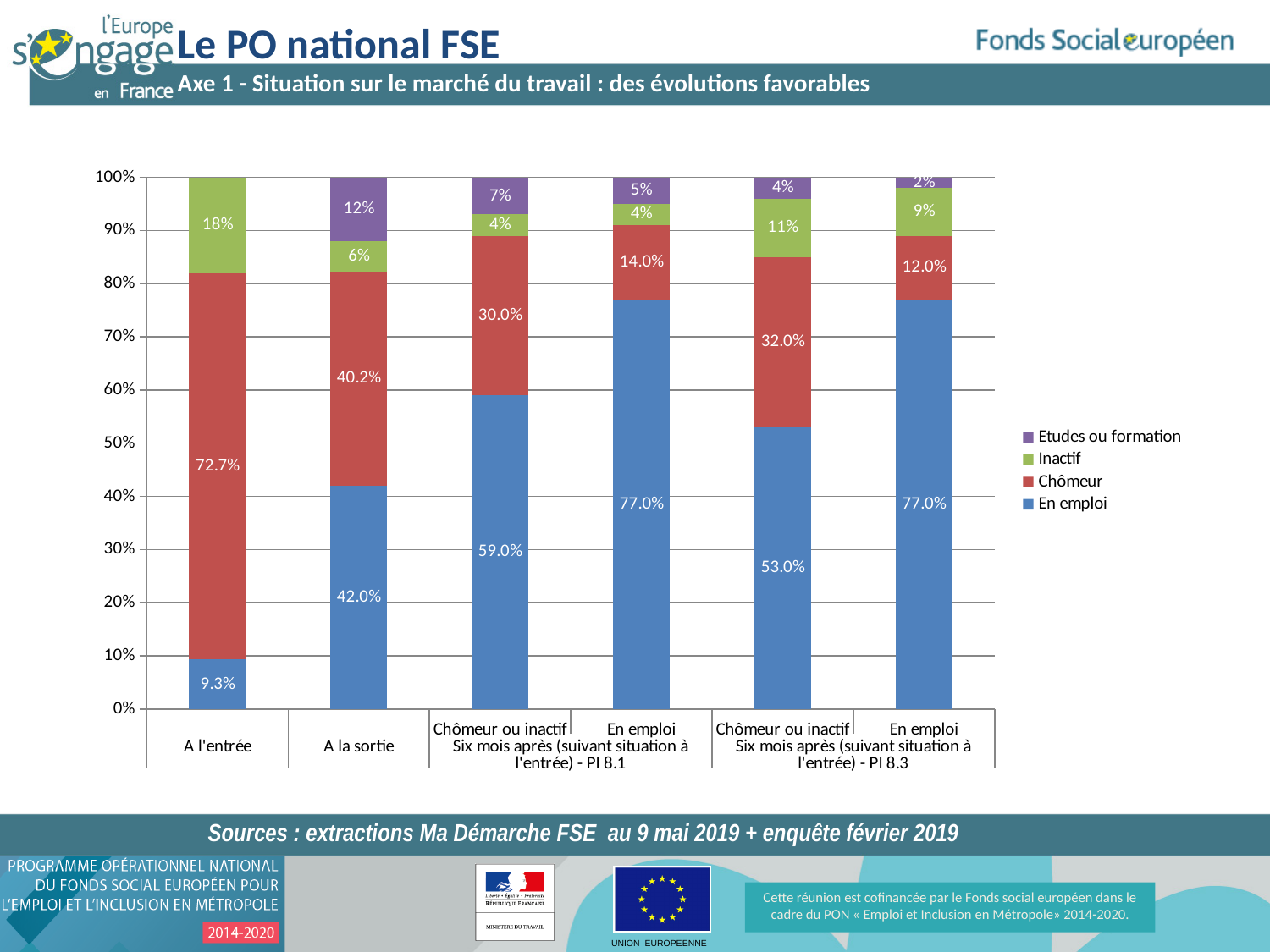
How many bars are shown in the chart? 6 What kind of chart is shown on the slide? Stacked bar chart What is the difference between the 'En emploi' values for 'A la sortie' and 'A l'entrée'? 32.7% Which bar has the lowest 'En emploi' value? A l'entrée What is the 'En emploi' value for the 'A l'entrée' bar? 9.3% What is the 'Etudes ou formation' value for the 'A la sortie' bar? 12% How many series does the legend list? 4 Which bar has the highest 'Chômeur' value? A l'entrée Which is larger: the 'En emploi' value for 'Chômeur ou inactif' under PI 8.1 or under PI 8.3? Chômeur ou inactif under PI 8.1 What is the 'Chômeur' value for the 'En emploi' bar under PI 8.1? 14.0% What is the 'Inactif' value for the 'Chômeur ou inactif' bar under PI 8.3? 11% What is the 'Chômeur' value for the 'A la sortie' bar? 40.2%